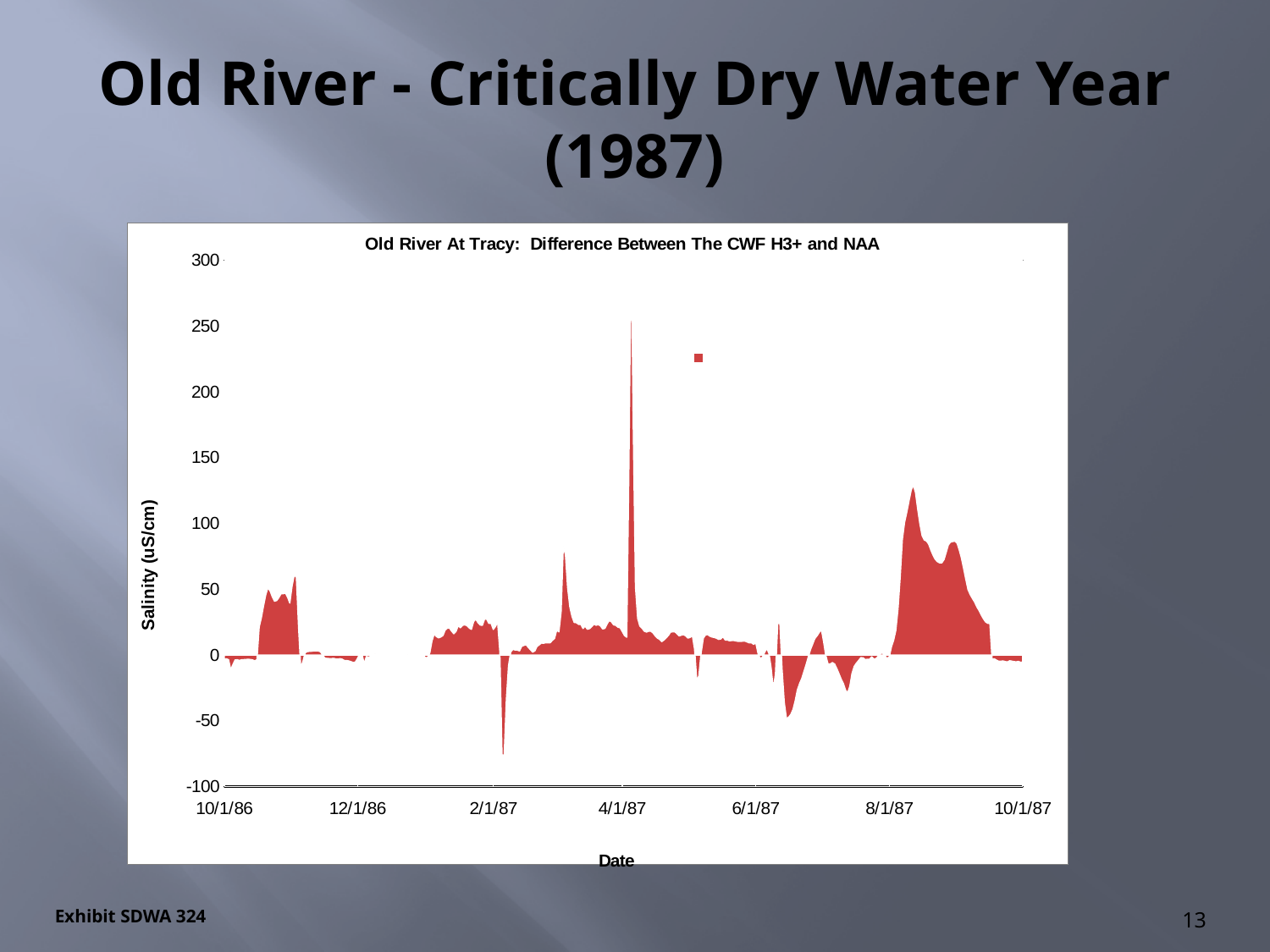
What is the label of the vertical axis? Salinity (uS/cm) How many date labels are shown on the horizontal axis? 7 Is the lowest value in the chart, near 2/1/87, greater or less than -50? less Is the peak value in the period after 8/1/87 greater or less than 100? greater Is the highest spike in the chart, near 4/1/87, greater or less than 200? greater What is the highest value shown on the vertical axis? 300 Around which date label does the highest spike in the chart occur? 4/1/87 What is the title of the chart? Old River At Tracy: Difference Between The CWF H3+ and NAA Which is larger: the spike near 4/1/87 or the peak after 8/1/87? The spike near 4/1/87 What kind of chart is shown on the slide? Area chart